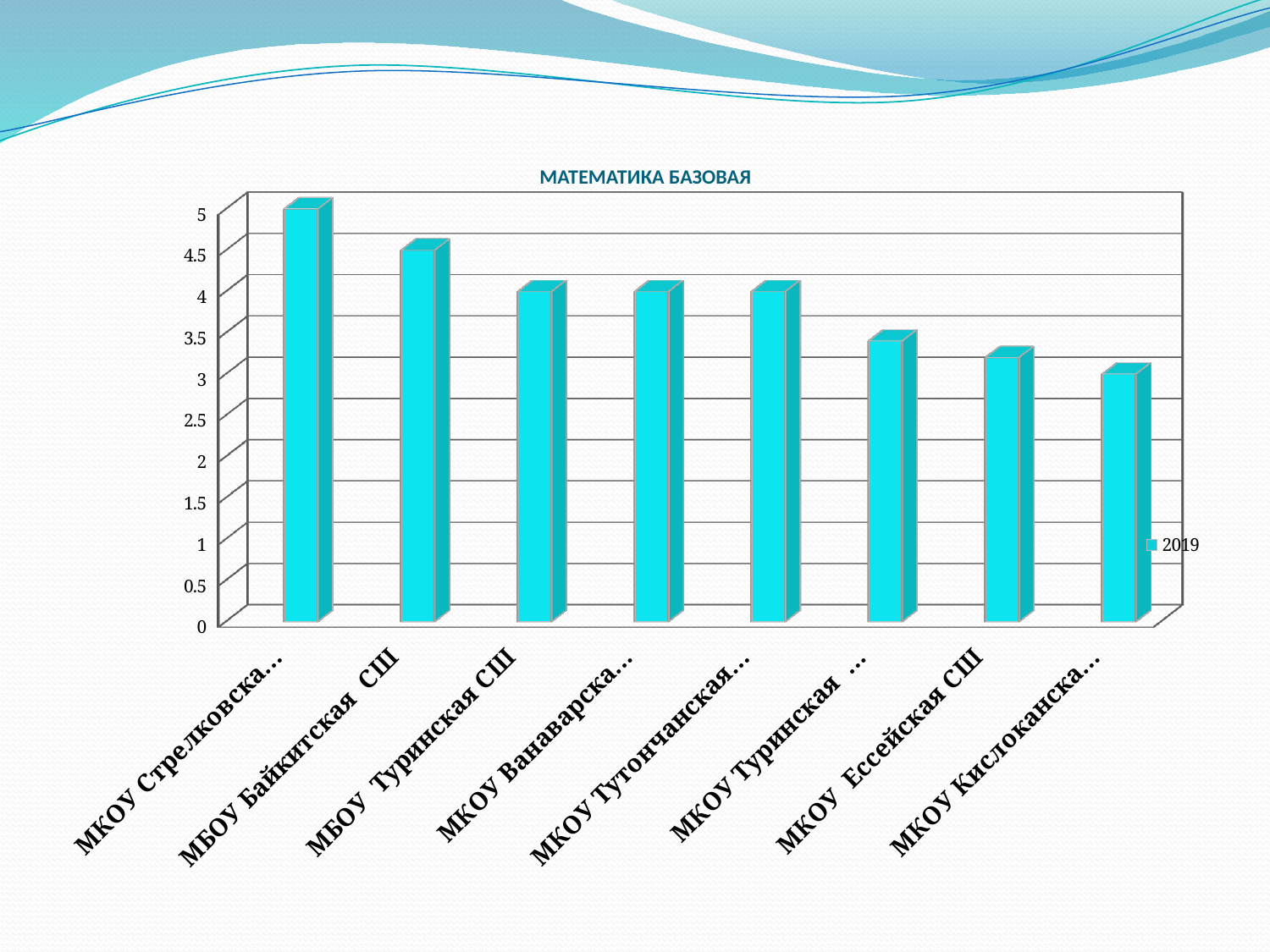
Do the values generally rise or fall from left to right along the x axis? fall What is the title of the chart? МАТЕМАТИКА БАЗОВАЯ What is the value for МБОУ Туринская СШ? 4 Is the value for МКОУ Ессейская СШ greater or less than 3.5? less What kind of chart is shown on the slide? bar chart How many series does the legend list? 1 What is the value for МБОУ Байкитская СШ? 4.5 Which school has the highest value on the chart? МКОУ Стрелковска… How many schools (categories) are plotted on the chart? 8 Which is larger, the value for МБОУ Байкитская СШ or the value for МКОУ Ессейская СШ? МБОУ Байкитская СШ Which school has the lowest value on the chart? МКОУ Кислоканска… What series name is shown in the legend? 2019